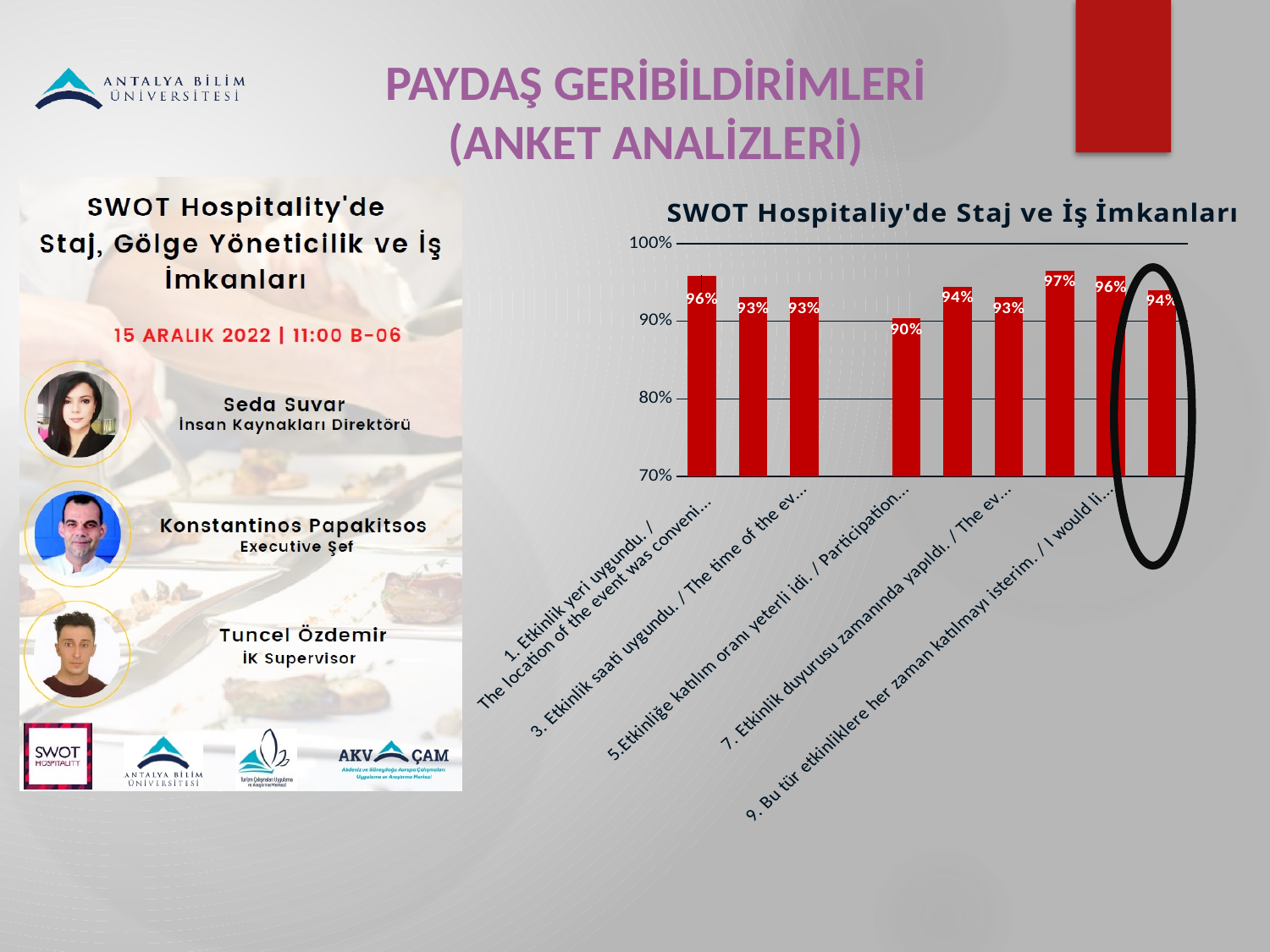
Which is larger: the value for category 1 (Etkinlik yeri uygundu) or category 3 (Etkinlik saati uygundu)? category 1 (Etkinlik yeri uygundu) What is the value for the category '3. Etkinlik saati uygundu. / The time of the ev...'? 93% What is the value for the category '1. Etkinlik yeri uygundu. / The location of the event was conveni...'? 96% What is the value for the category '5.Etkinliğe katılım oranı yeterli idi. / Participation...'? 90% What is the value for the category '7. Etkinlik duyurusu zamanında yapıldı. / The ev...'? 93% What is the value of the last bar on the right, which is circled in black? 94% Which labelled category has the lowest value in the chart? 5.Etkinliğe katılım oranı yeterli idi. / Participation... What is the highest value shown by any bar in the chart? 97% What is the title of the chart on the slide? SWOT Hospitaliy'de Staj ve İş İmkanları What is the value for the category '9. Bu tür etkinliklere her zaman katılmayı isterim. / I would li...'? 96% What is the difference between the value for category 1 (Etkinlik yeri uygundu) and category 5 (Etkinliğe katılım oranı yeterli idi)? 6 percentage points What type of chart is shown on the right side of the slide? bar chart